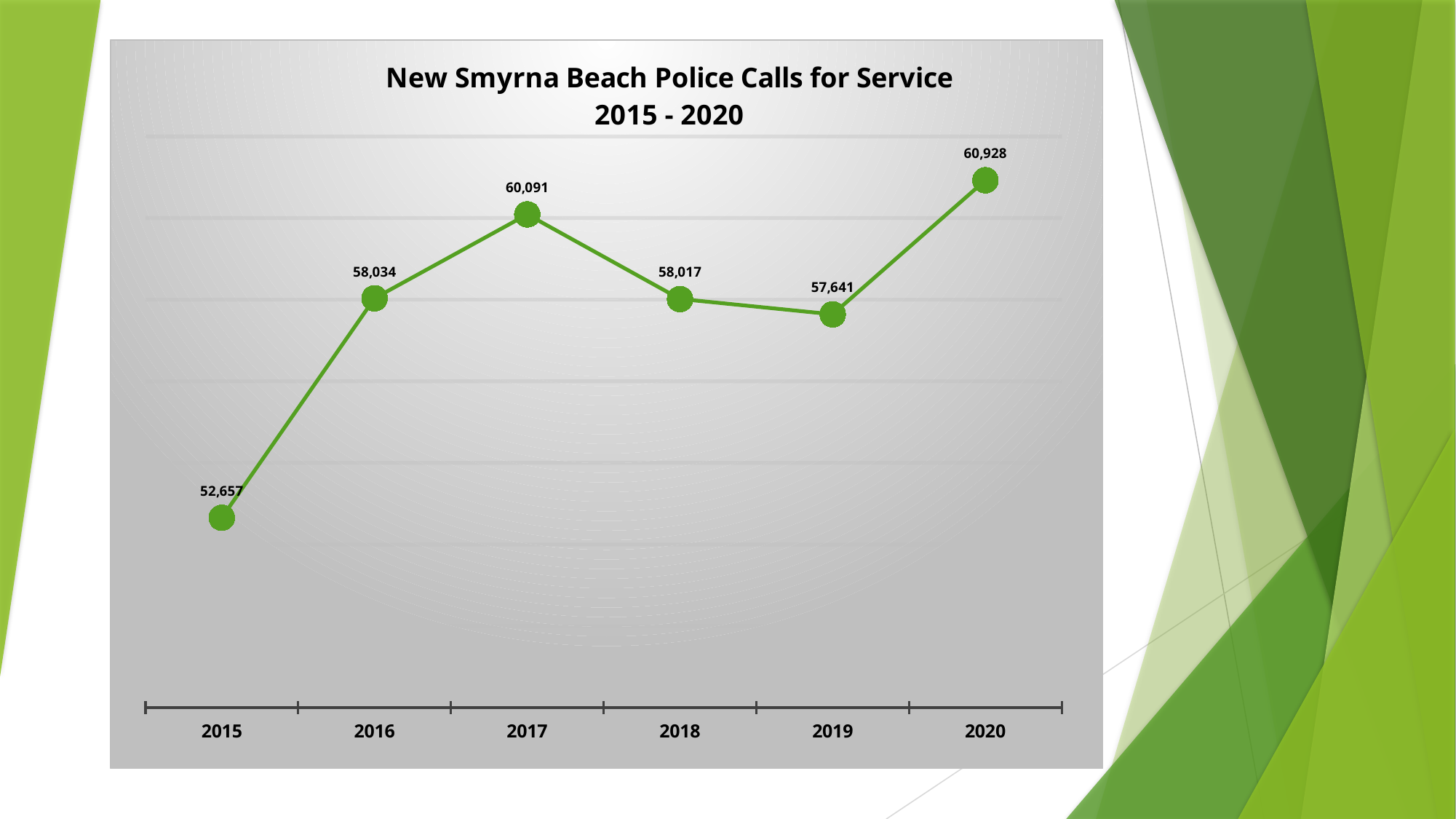
Which year had more calls for service, 2016 or 2019? 2016 What is the number of calls for service in 2017? 60,091 What is the title of the chart? New Smyrna Beach Police Calls for Service 2015 - 2020 What is the difference in calls for service between 2020 and 2015? 8,271 Which year has the lowest number of calls for service? 2015 What is the number of calls for service in 2019? 57,641 What is the number of calls for service in 2015? 52,657 Which year has the highest number of calls for service? 2020 What is the difference in calls for service between 2017 and 2016? 2,057 What kind of chart is shown on the slide? Line chart What is the number of calls for service in 2020? 60,928 How many years are plotted on the chart? 6